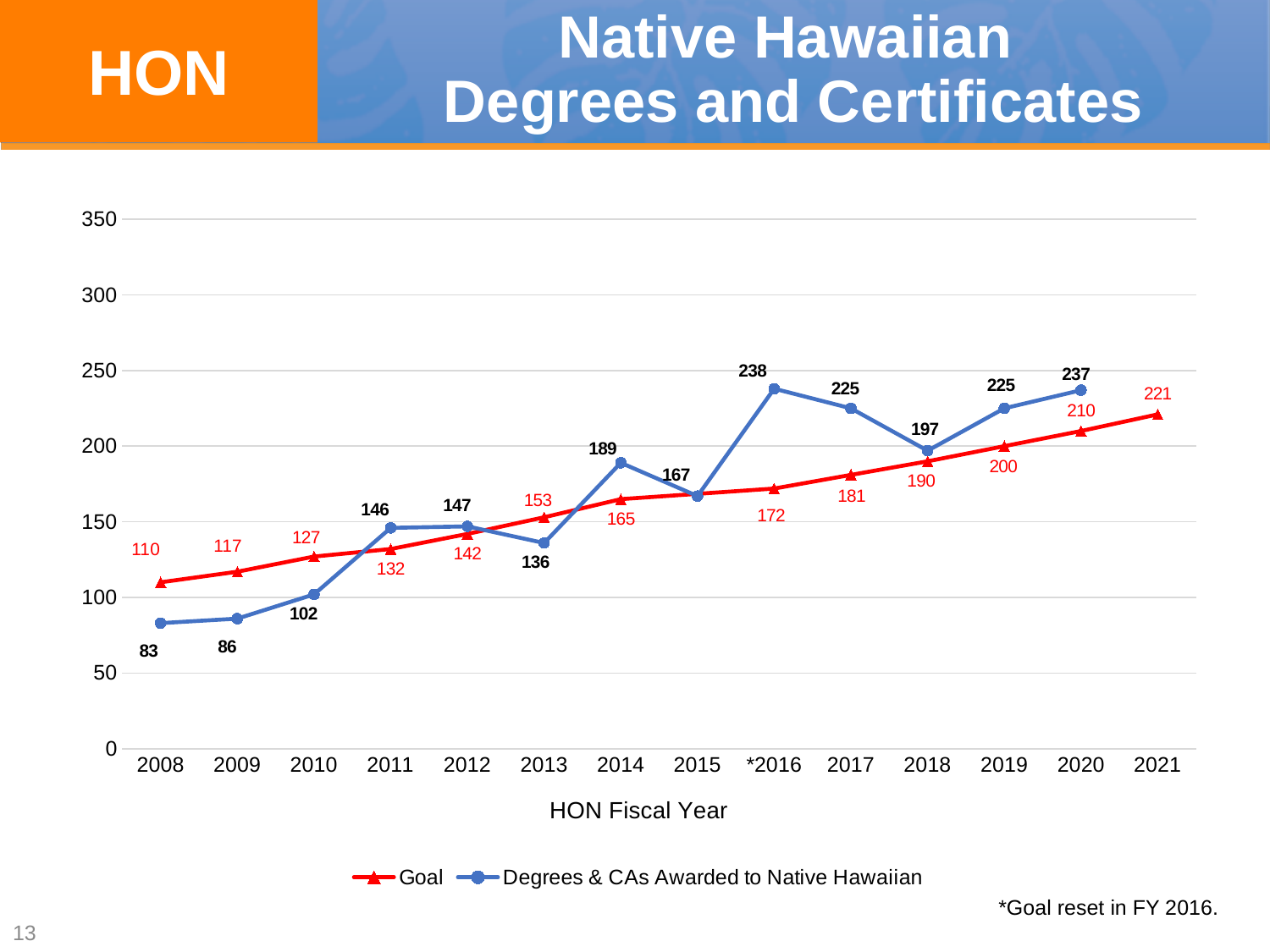
In which fiscal year is the Degrees & CAs Awarded to Native Hawaiian value lowest? 2008 In 2013, which is larger: the Goal or Degrees & CAs Awarded to Native Hawaiian? Goal What is the Goal value for 2019? 200 How many fiscal years are shown on the x axis? 14 What kind of chart is shown on the slide? line chart Is the Goal value for 2021 greater or less than 200? greater What is the value of Degrees & CAs Awarded to Native Hawaiian in 2008? 83 What is the value of Degrees & CAs Awarded to Native Hawaiian in 2014? 189 In which fiscal year is the Degrees & CAs Awarded to Native Hawaiian value highest? *2016 What is the difference between Degrees & CAs Awarded to Native Hawaiian and the Goal in *2016? 66 How many series does the legend list? 2 Does the Goal series rise or fall from 2008 to 2021? rise